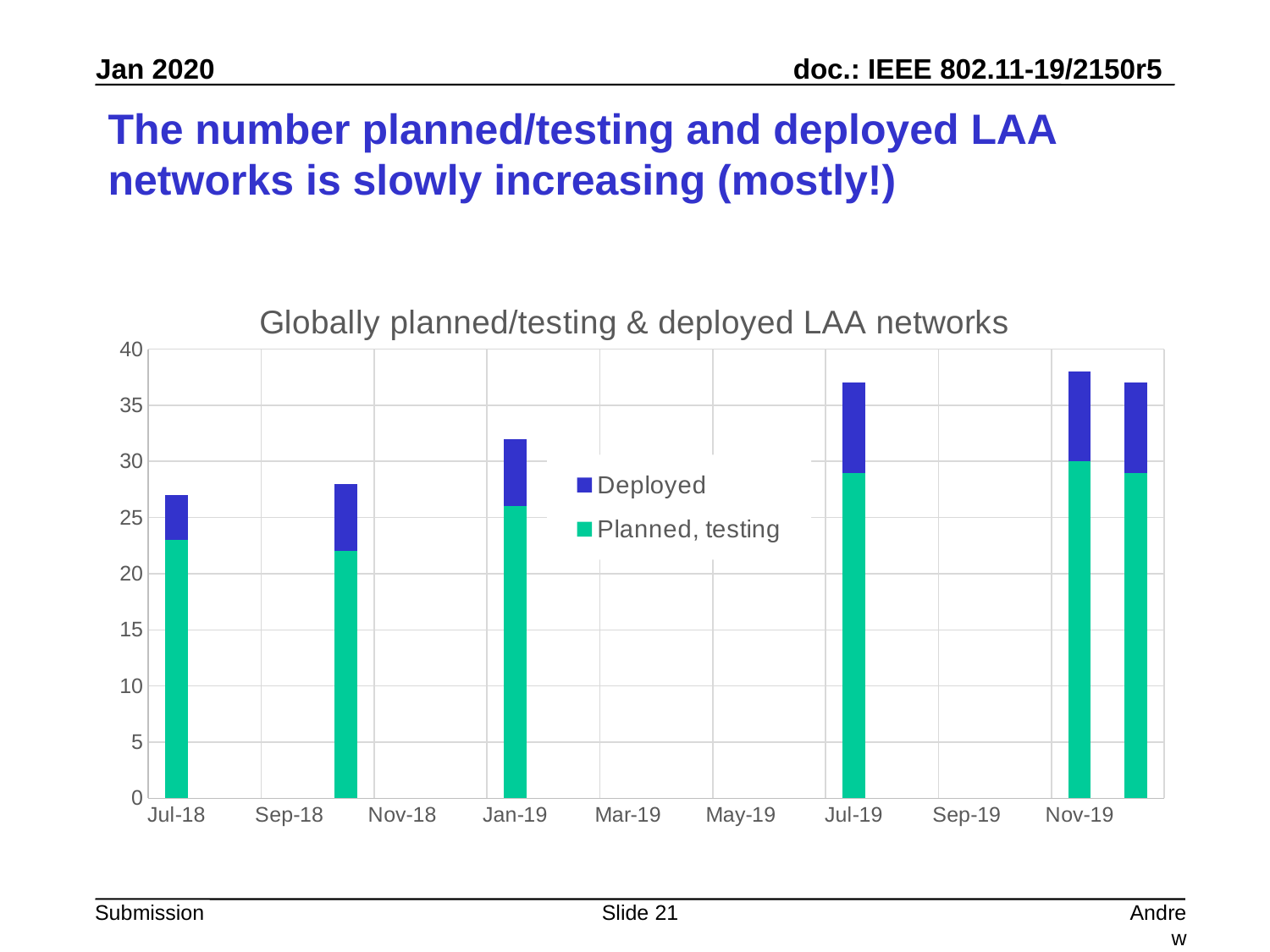
Which colour represents the 'Deployed' series in the chart? Blue How many series does the legend list? 2 What is the title of the chart? Globally planned/testing & deployed LAA networks Which bar is taller in total, Nov-19 or Jul-18? Nov-19 Is the total height of the Nov-19 bar greater or less than 35? greater Do the total bar heights generally rise or fall from Jul-18 to Nov-19? Rise Is the total height of the Jul-18 bar greater or less than 30? less What kind of chart is shown on the slide? Stacked bar chart Is the total height of the Jan-19 bar greater or less than 30? greater How many bars are plotted in the chart? 6